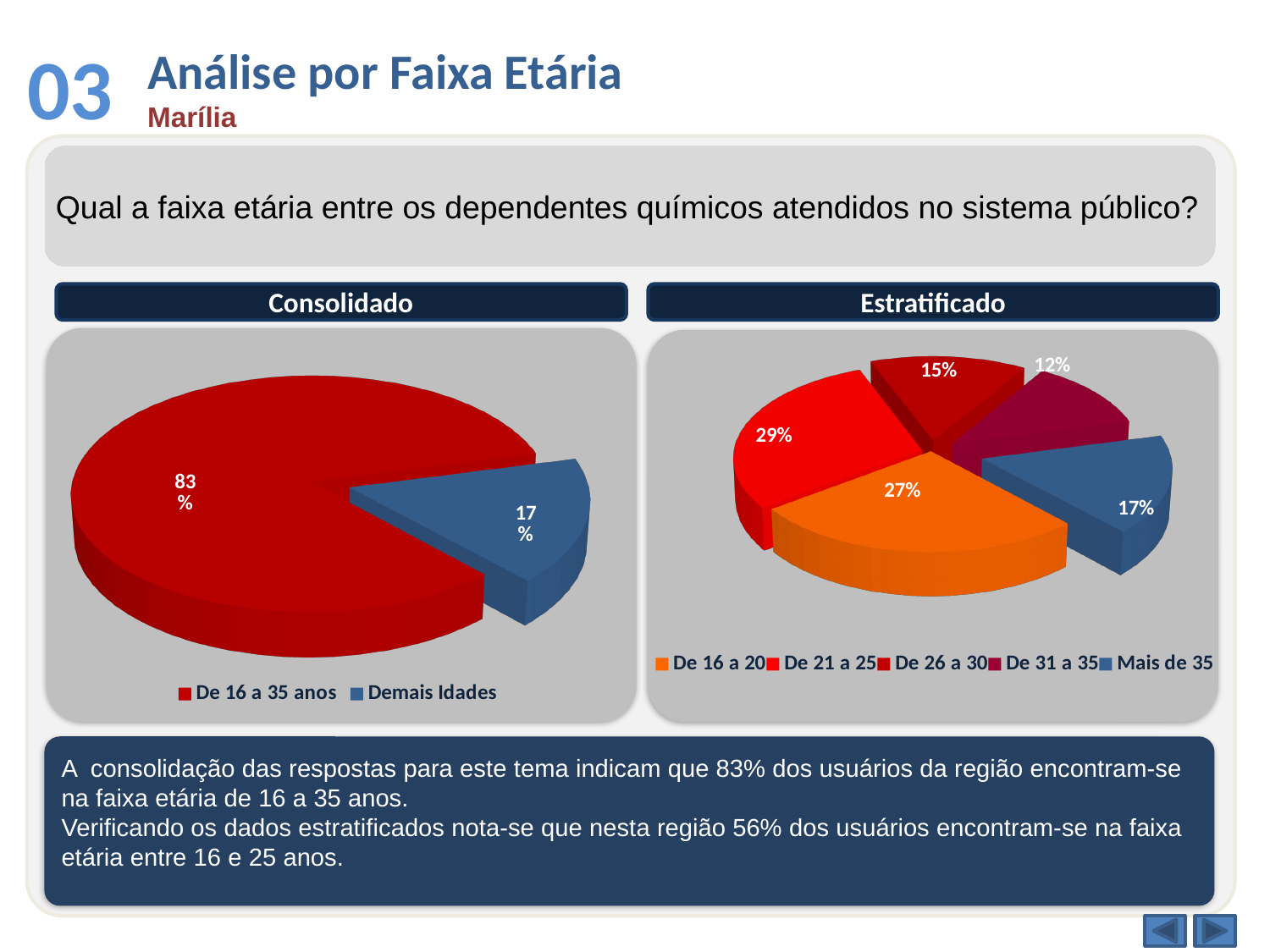
In the Consolidado chart, what share is shown for Demais Idades? 17% In the Estratificado chart, what share is shown for Mais de 35? 17% In the Estratificado chart, which category has the smallest share? De 31 a 35 In the Estratificado chart, which is larger: the share for De 16 a 20 or the share for Mais de 35? De 16 a 20 How many categories does the legend of the Estratificado chart list? 5 In the Consolidado chart, what share is shown for De 16 a 35 anos? 83% In the Estratificado chart, which category has the largest share? De 21 a 25 What kind of chart is the Consolidado chart? Pie chart In the Estratificado chart, what is the difference between the shares for De 26 a 30 and De 31 a 35? 3% In the Estratificado chart, what share is shown for De 21 a 25? 29% In the Estratificado chart, what share is shown for De 16 a 20? 27% How many slices does the Consolidado chart have? 2